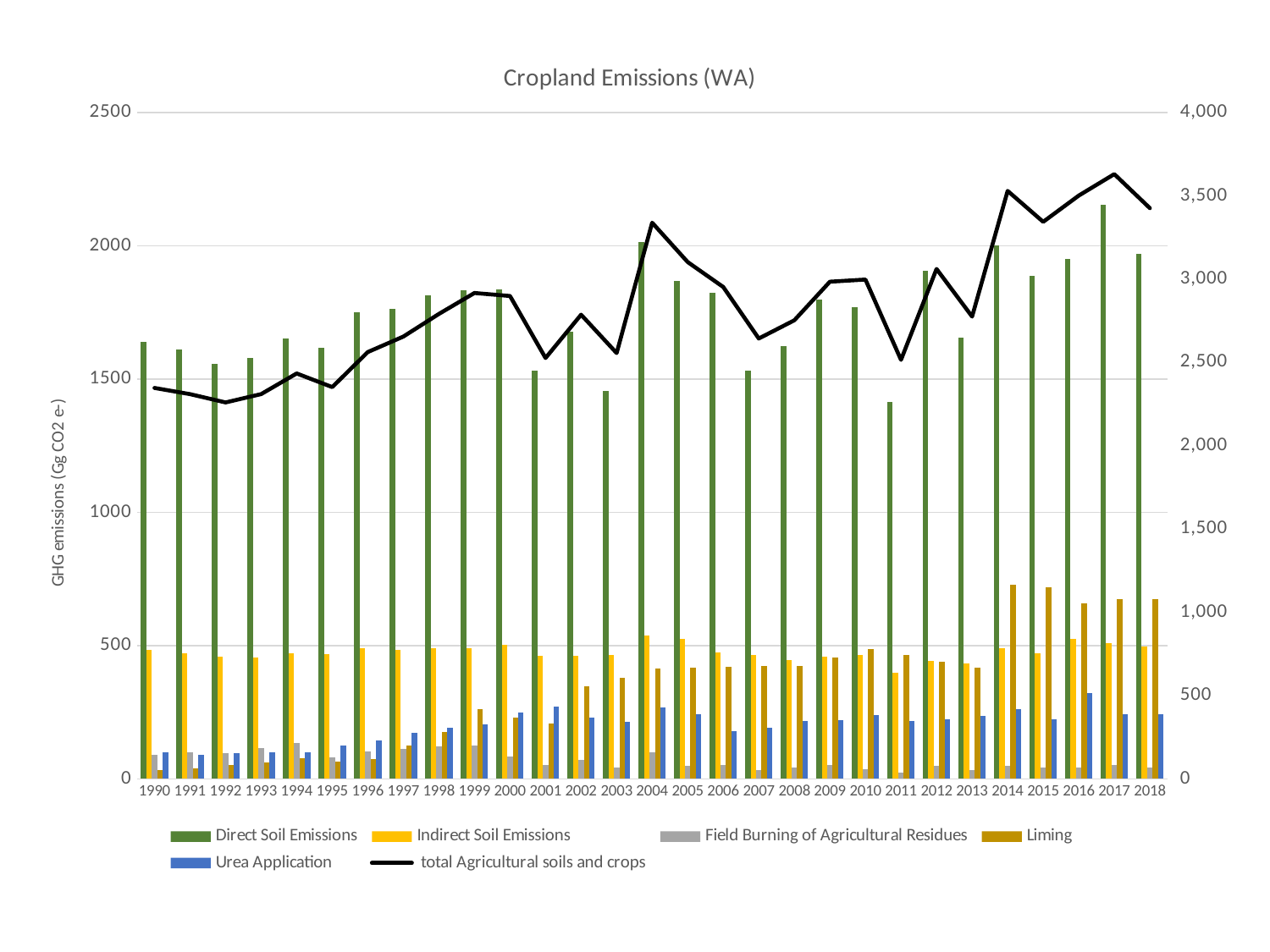
Does the total Agricultural soils and crops line generally rise or fall from 1990 to 2018? rise In which year is the Direct Soil Emissions bar highest? 2017 In which year is the total Agricultural soils and crops line at its lowest? 1992 Is the Direct Soil Emissions value for 2017 greater or less than 2000? greater Which year has the larger Liming value, 1990 or 2018? 2018 Is the total Agricultural soils and crops value for 1990 greater or less than 2,500 on the right axis? less Is the Direct Soil Emissions value for 2011 greater or less than 1500? less In which year is the total Agricultural soils and crops line at its highest? 2017 What is the title of the chart? Cropland Emissions (WA) How many series does the legend list? 6 How many years are shown on the x axis? 29 What type of chart is shown on the slide? Bar chart with a line